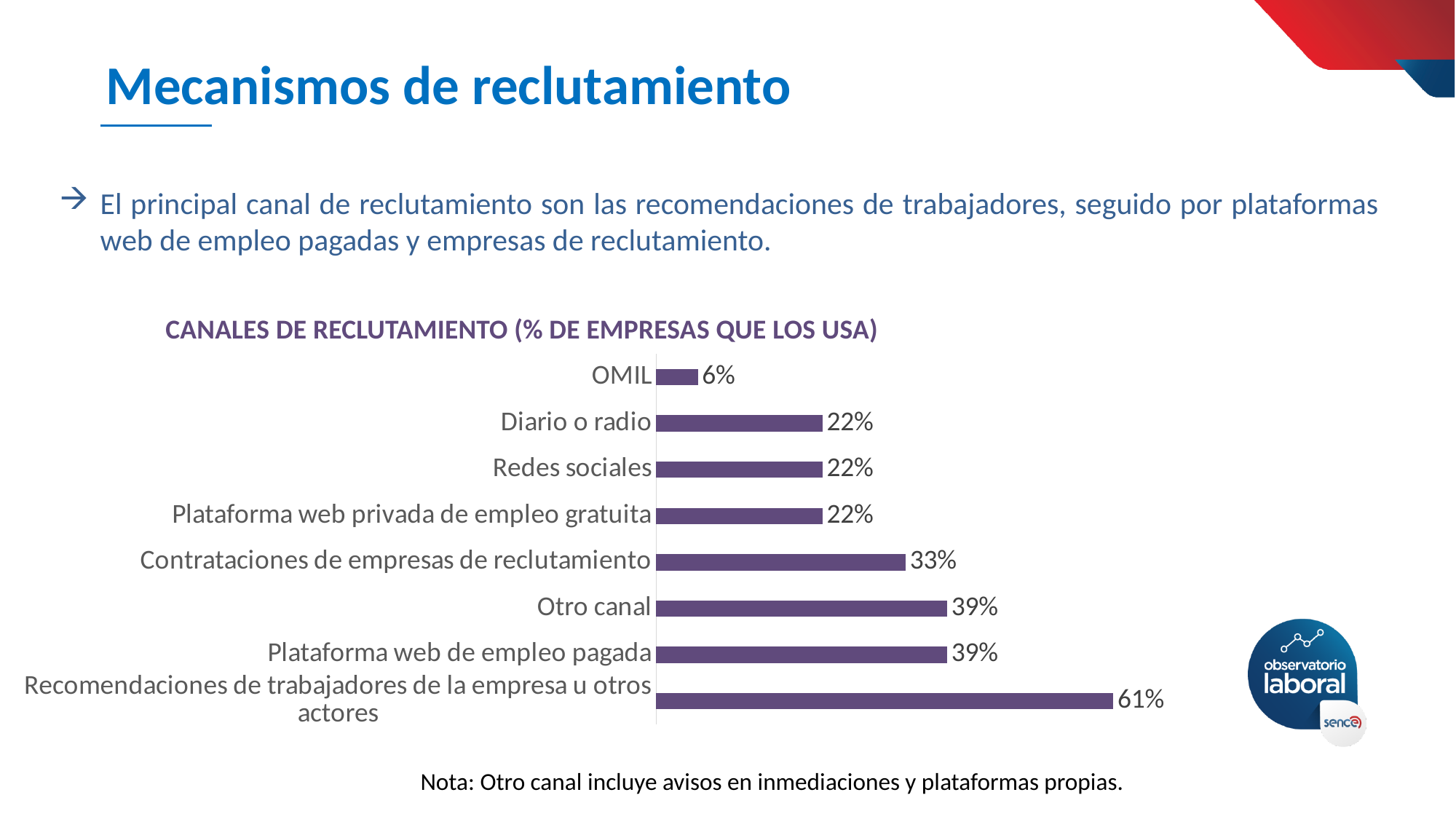
What type of chart is shown on the slide? Bar chart What is the difference between the values for Otro canal and OMIL? 33% Which category has the highest value? Recomendaciones de trabajadores de la empresa u otros actores What is the value for Contrataciones de empresas de reclutamiento? 33% Which is larger, the value for Contrataciones de empresas de reclutamiento or the value for Diario o radio? Contrataciones de empresas de reclutamiento What is the difference between the values for Recomendaciones de trabajadores de la empresa u otros actores and Plataforma web de empleo pagada? 22% What is the value for Recomendaciones de trabajadores de la empresa u otros actores? 61% Which category has the lowest value? OMIL What is the value for Redes sociales? 22% What is the title of the chart? CANALES DE RECLUTAMIENTO (% DE EMPRESAS QUE LOS USA) What is the value for OMIL? 6% How many categories are shown in the chart? 8